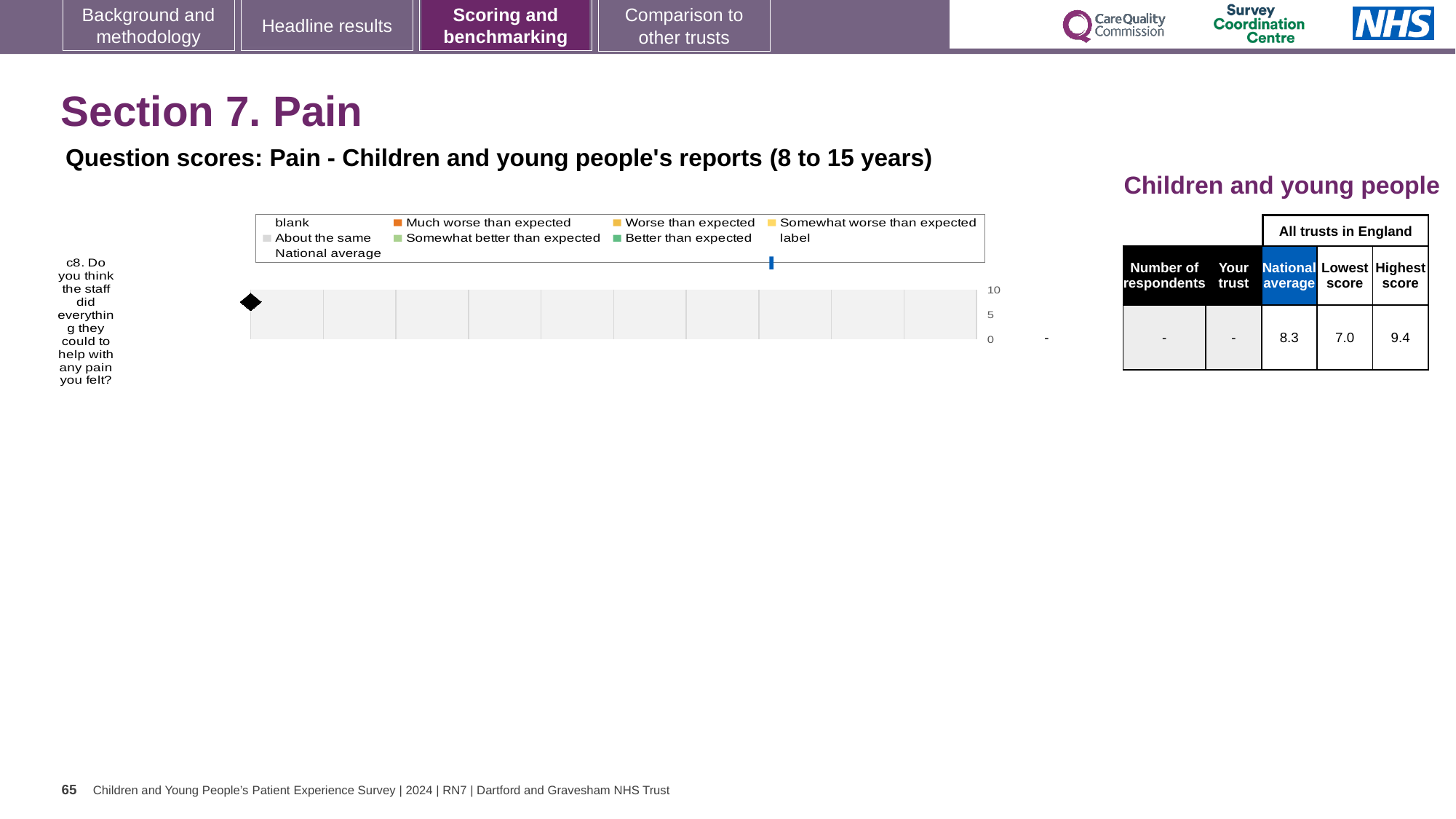
In the table next to the chart, what is the Lowest score across all trusts in England for question c8? 7.0 Is the National average score of 8.3 for question c8 greater or less than 5 on the chart's axis? greater In the table next to the chart, what is the Highest score across all trusts in England for question c8? 9.4 What is the highest value shown on the chart's axis? 10 Which question is plotted on the chart? c8. Do you think the staff did everything they could to help with any pain you felt? In the table next to the chart, what is shown for Your trust for question c8? - What is the difference between the Highest score and the Lowest score shown in the table for question c8? 2.4 What kind of chart is shown on the slide? bar chart In the table next to the chart, what is the National average score for question c8? 8.3 How many question categories are plotted on the chart? 1